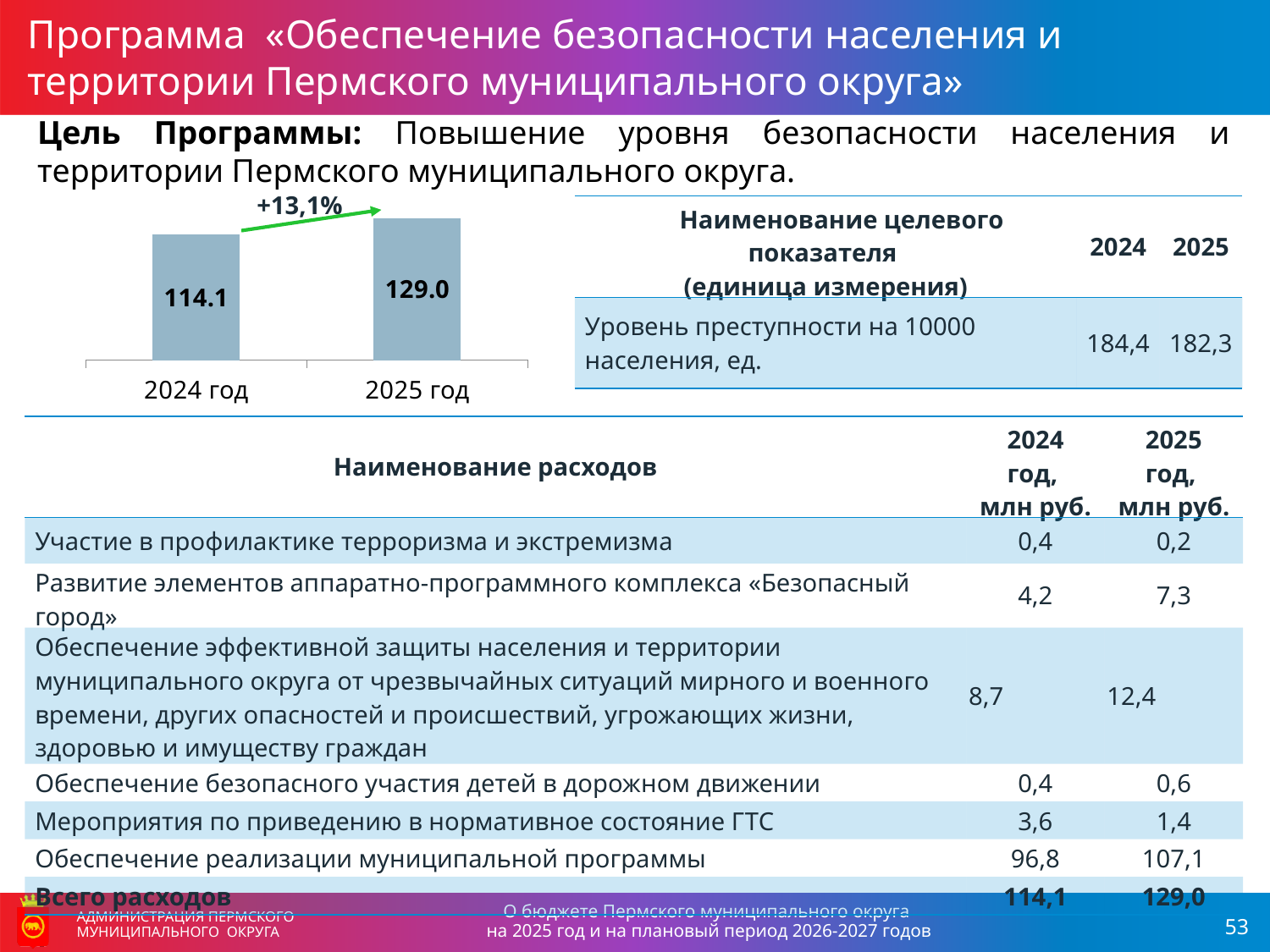
Which category has the lowest bar in the chart? 2024 год Is the value for 2024 год in the chart greater or less than 129.0? less What is the difference between the 2025 год and 2024 год values in the chart? 14.9 What is the value of the bar for 2024 год in the chart? 114.1 What kind of chart is shown on the slide? bar chart Do the values in the chart rise or fall from 2024 год to 2025 год? rise Which category has the highest bar in the chart? 2025 год Which is larger in the chart, the value for 2024 год or for 2025 год? 2025 год How many bars are shown in the chart? 2 What is the value of the bar for 2025 год in the chart? 129.0 What percentage change is annotated above the bars in the chart? +13,1%